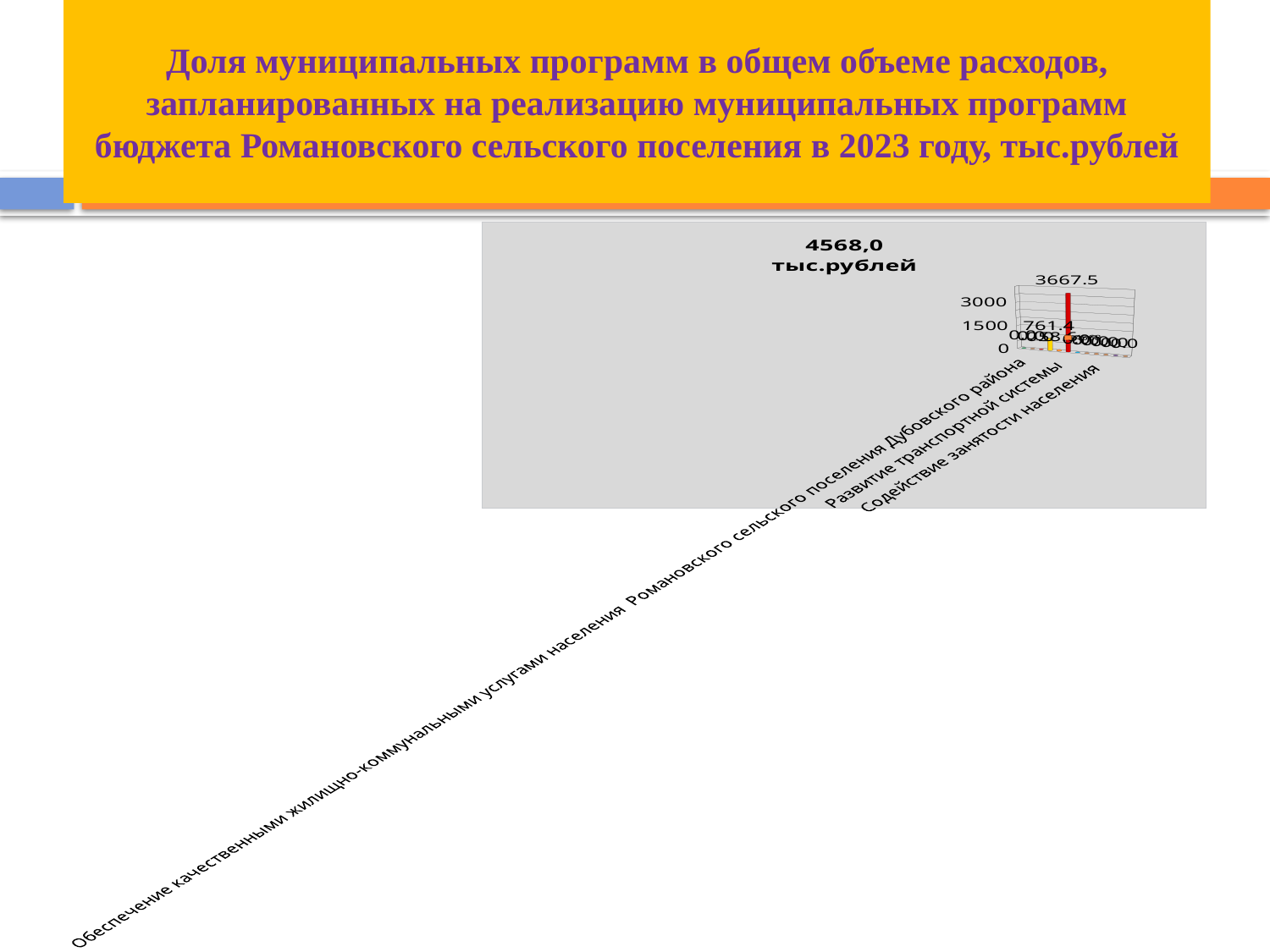
What kind of chart is shown on the slide? bar chart What is the difference between the two printed data labels 3667.5 and 761.4? 2906.1 What is the largest value printed as a data label on the chart? 3667.5 Is the value of the tallest bar greater or less than 3000? greater What is the title printed above the chart? 4568,0 тыс.рублей Is the value of the bar labelled 761.4 greater or less than 1500? less Which is larger, the bar labelled 3667.5 or the bar labelled 761.4? 3667.5 What is the highest tick value shown on the vertical axis? 3000